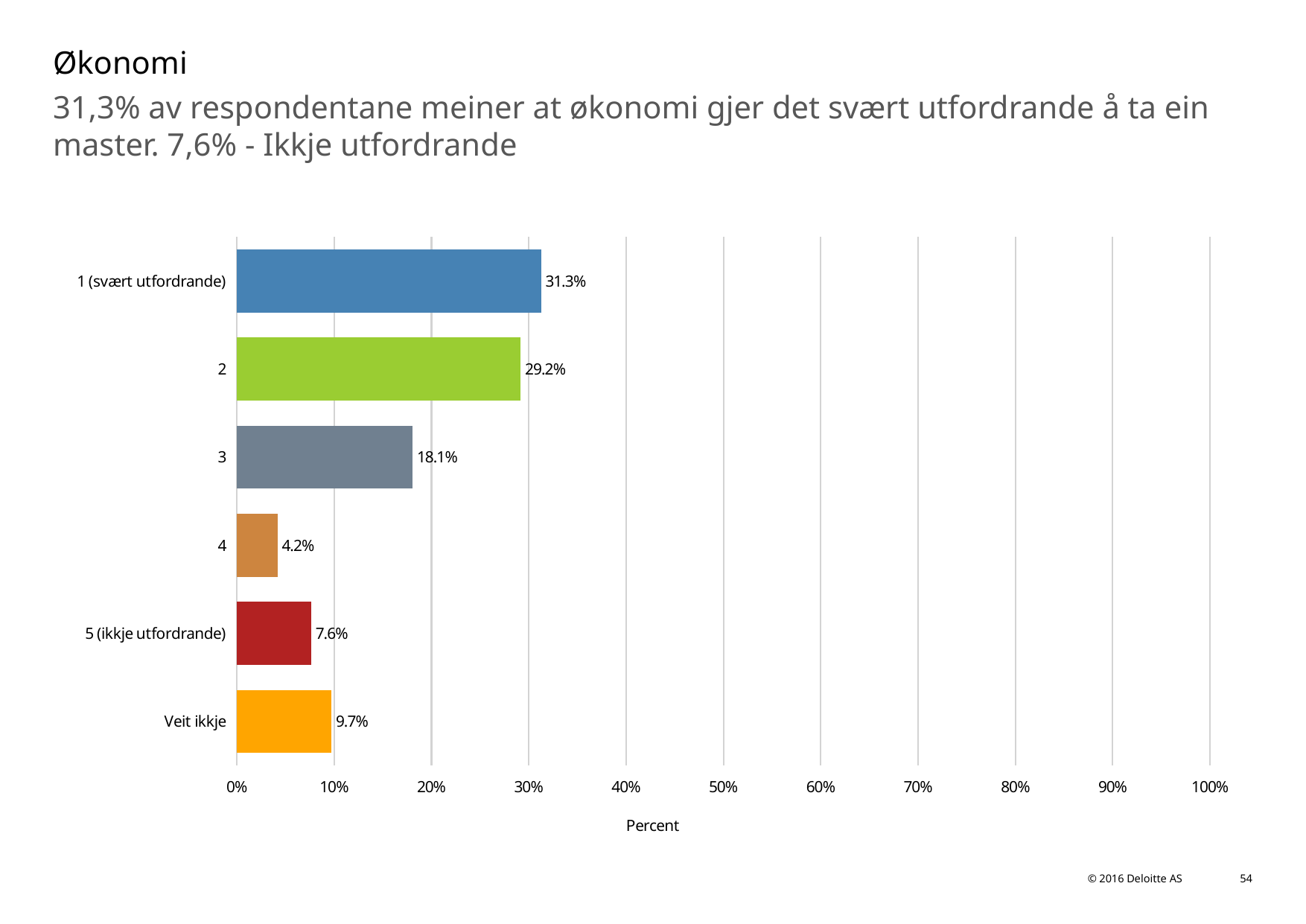
What kind of chart is shown on the slide? bar chart What is the value for '5 (ikkje utfordrande)'? 7.6% What is the difference between the values for '1 (svært utfordrande)' and '2'? 2.1% What is the value for 'Veit ikkje'? 9.7% What is the label of the horizontal axis? Percent What is the value for '1 (svært utfordrande)'? 31.3% How many categories are shown in the chart? 6 Which is larger, the value for '5 (ikkje utfordrande)' or the value for 'Veit ikkje'? Veit ikkje Which category has the lowest value? 4 Which category has the highest value? 1 (svært utfordrande) What is the value for category '3'? 18.1% Is the value for category '3' greater or less than 20%? less